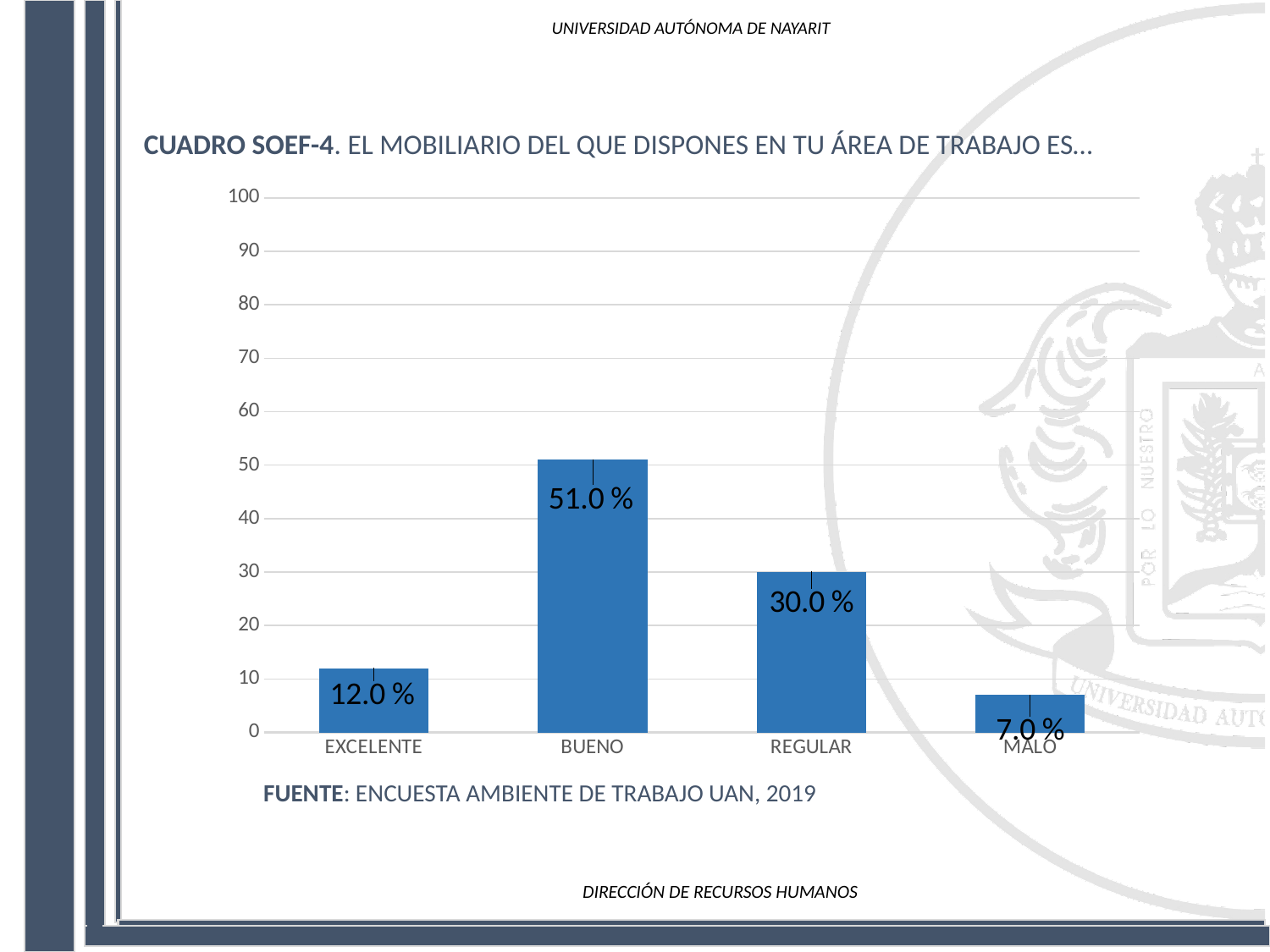
What is the value for MALO? 7.0 % What is the value for REGULAR? 30.0 % What kind of chart is shown on the slide? bar chart What is the value for BUENO? 51.0 % How many categories are shown on the x axis? 4 Which is larger, the value for EXCELENTE or the value for MALO? EXCELENTE Which category has the lowest value? MALO What is the value for EXCELENTE? 12.0 % Is the value for REGULAR greater or less than 40? less Which category has the highest value? BUENO What is the difference between the values for BUENO and REGULAR? 21.0 % What source is cited below the chart? ENCUESTA AMBIENTE DE TRABAJO UAN, 2019